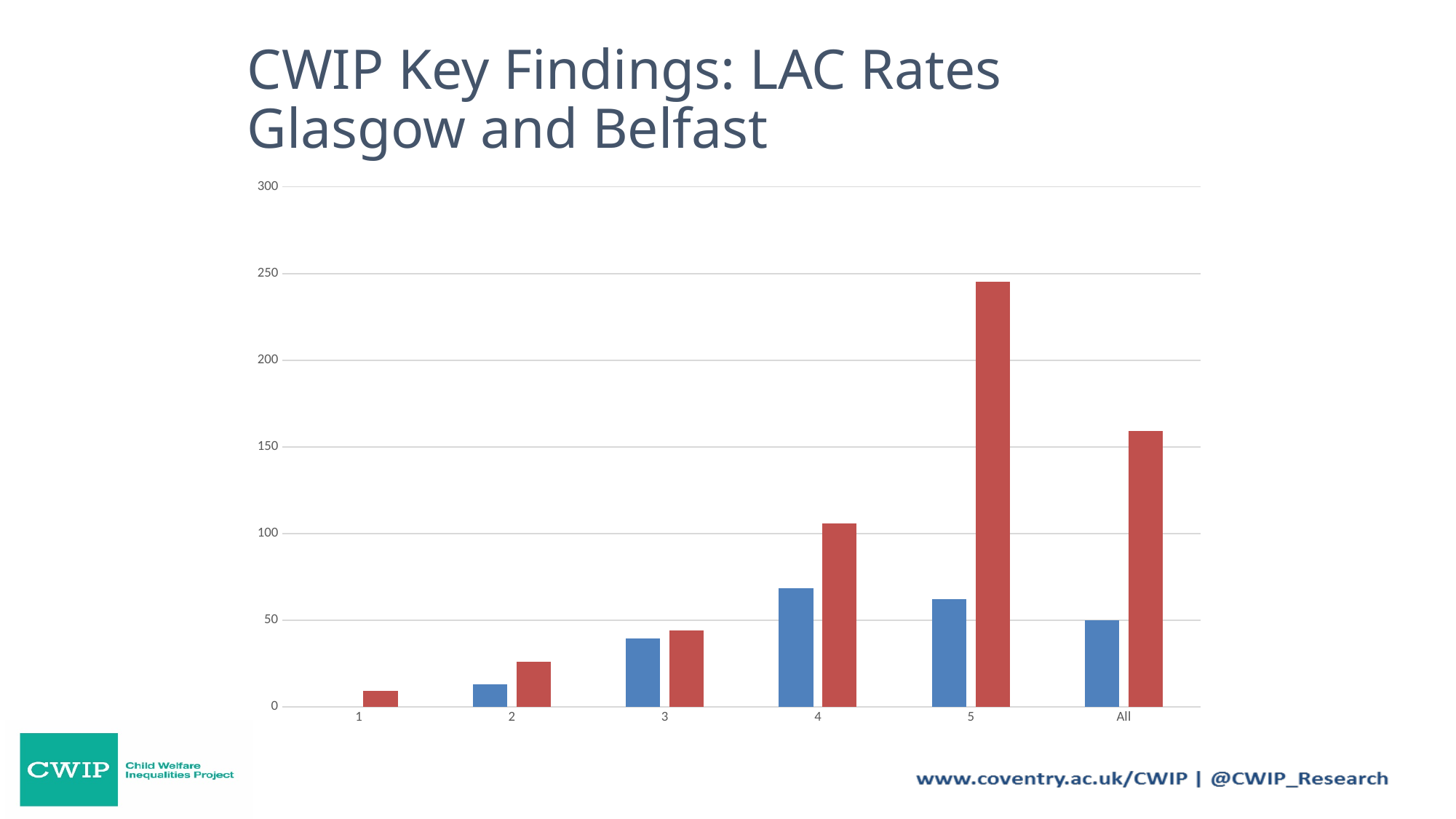
Is the value of the red bar for All greater or less than 150? greater How many categories are shown on the x axis of the chart? 6 What is the title of the slide containing the chart? CWIP Key Findings: LAC Rates Glasgow and Belfast Is the value of the red bar for category 5 greater or less than 200? greater Is the value of the blue bar for category 3 greater or less than 50? less What kind of chart is shown on the slide? bar chart For category 5, which bar is taller, the red bar or the blue bar? red bar Which category has the tallest red bar? 5 Which category has the shortest red bar? 1 Do the red bars rise or fall from category 1 to category 5? rise